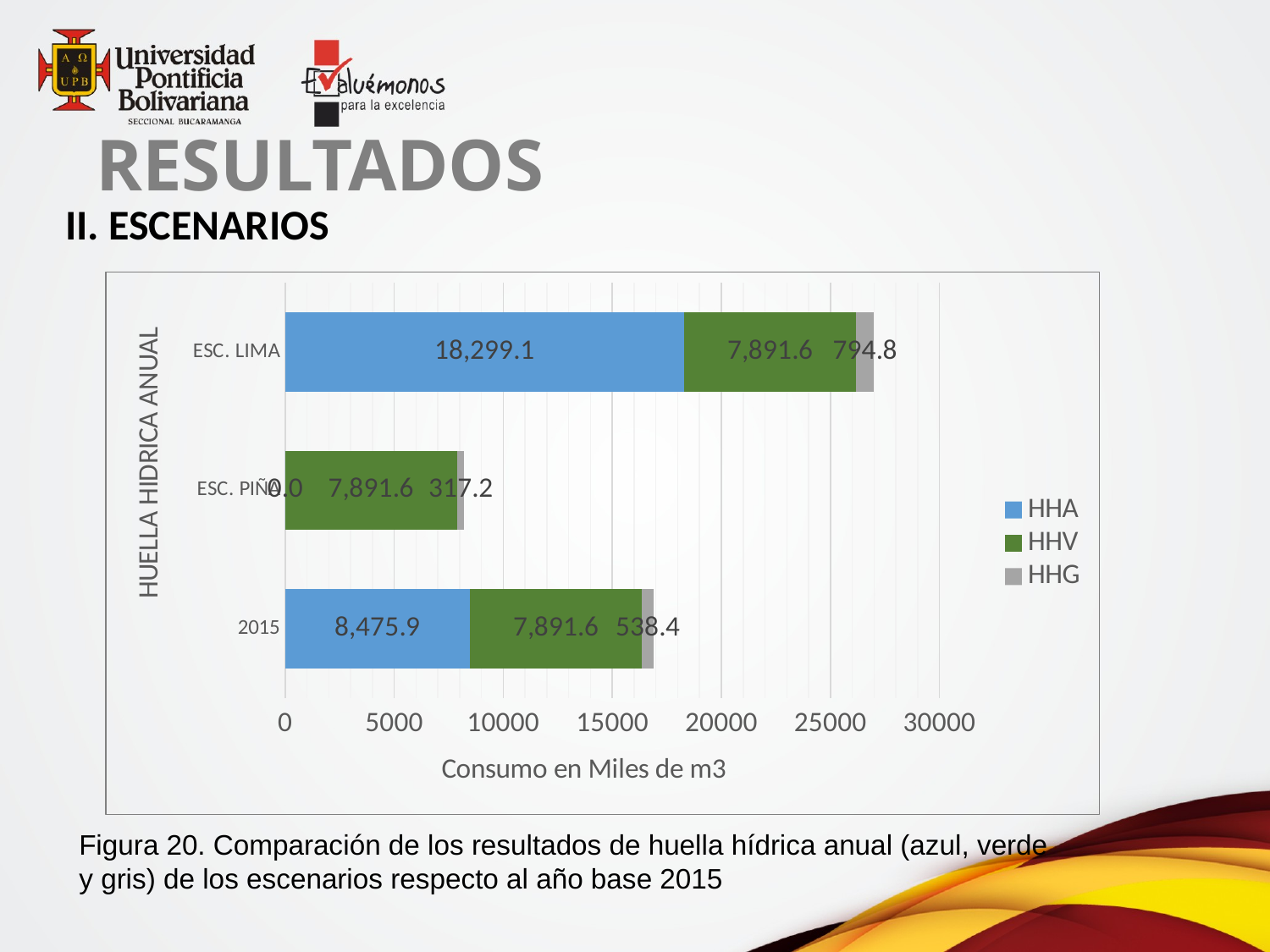
What is the HHA value for ESC. PIÑA? 0.0 How many series does the legend list? 3 What is the HHA value for ESC. LIMA? 18,299.1 What kind of chart is shown on the slide? Stacked bar chart Which category has the highest HHA value? ESC. LIMA What is the total of the stacked bar for ESC. PIÑA? 8,208.8 How many categories are shown on the y axis? 3 What is the difference between the HHA value for ESC. LIMA and the HHA value for 2015? 9,823.2 What is the HHV value for 2015? 7,891.6 What is the HHG value for 2015? 538.4 Which category has the lowest HHG value? ESC. PIÑA Which is larger, the HHG value for ESC. LIMA or the HHG value for 2015? ESC. LIMA